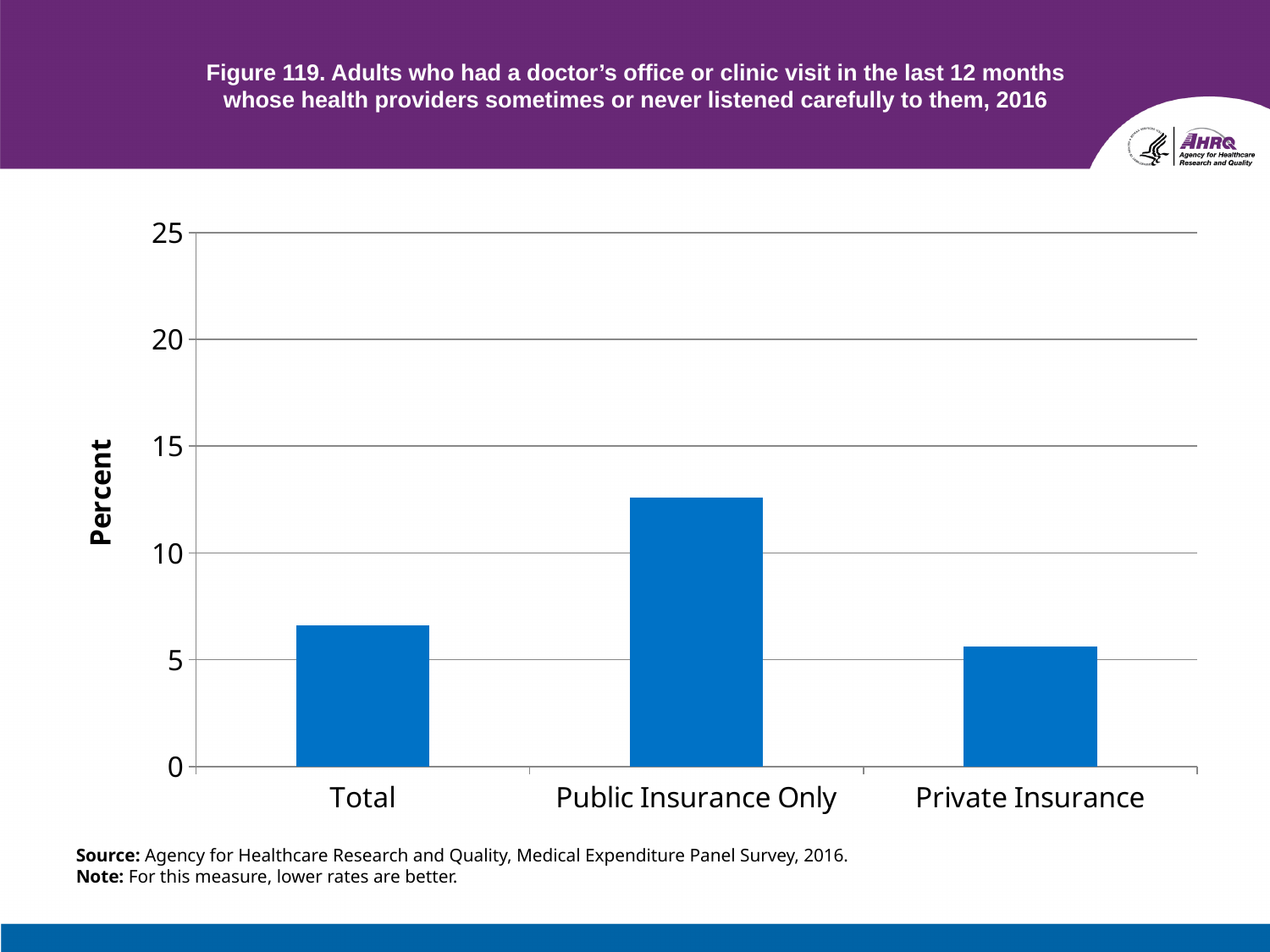
How many categories are shown on the x axis of the chart? 3 What is the highest tick value shown on the y axis? 25 Is the value for Public Insurance Only greater or less than 10? greater What is the label on the y axis of the chart? Percent Is the value for Public Insurance Only greater or less than 15? less Is the value for Total greater or less than 5? greater Which is larger, the value for Public Insurance Only or the value for Private Insurance? Public Insurance Only What kind of chart is shown on the slide? bar chart Which category has the lowest value in the chart? Private Insurance Which category has the highest value in the chart? Public Insurance Only